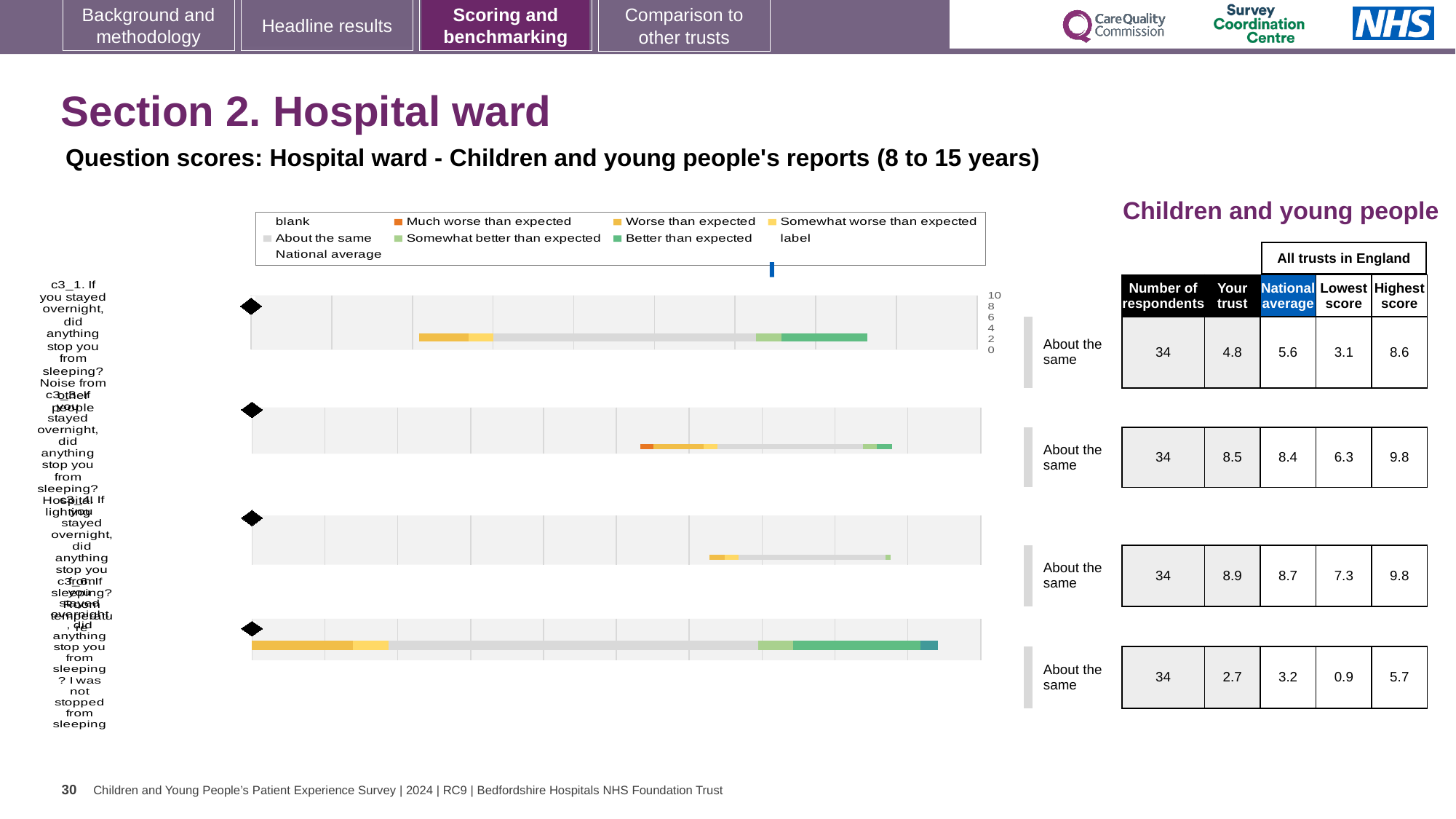
For the fourth question row, which is larger: the 'Your trust' score or the national average? the national average (3.2) What is the difference between the highest score (8.6) and the lowest score (3.1) for the first question row? 5.5 How many respondents are listed for each question row? 34 What benchmark category is shown for all four question rows? About the same Which question row has the highest 'Your trust' score? the third row (8.9) What is the highest score across all trusts in England for the second question row? 9.8 How many question rows (bars) are plotted in the chart? 4 Which question row has the lowest 'Your trust' score? the fourth row (2.7) What is the national average score for the first question row (c3_1)? 5.6 What is the 'Your trust' score for the first question row (c3_1, noise from other people)? 4.8 What is the lowest score across all trusts in England for the fourth question row? 0.9 What kind of chart is used to show the question scores on this slide? bar chart